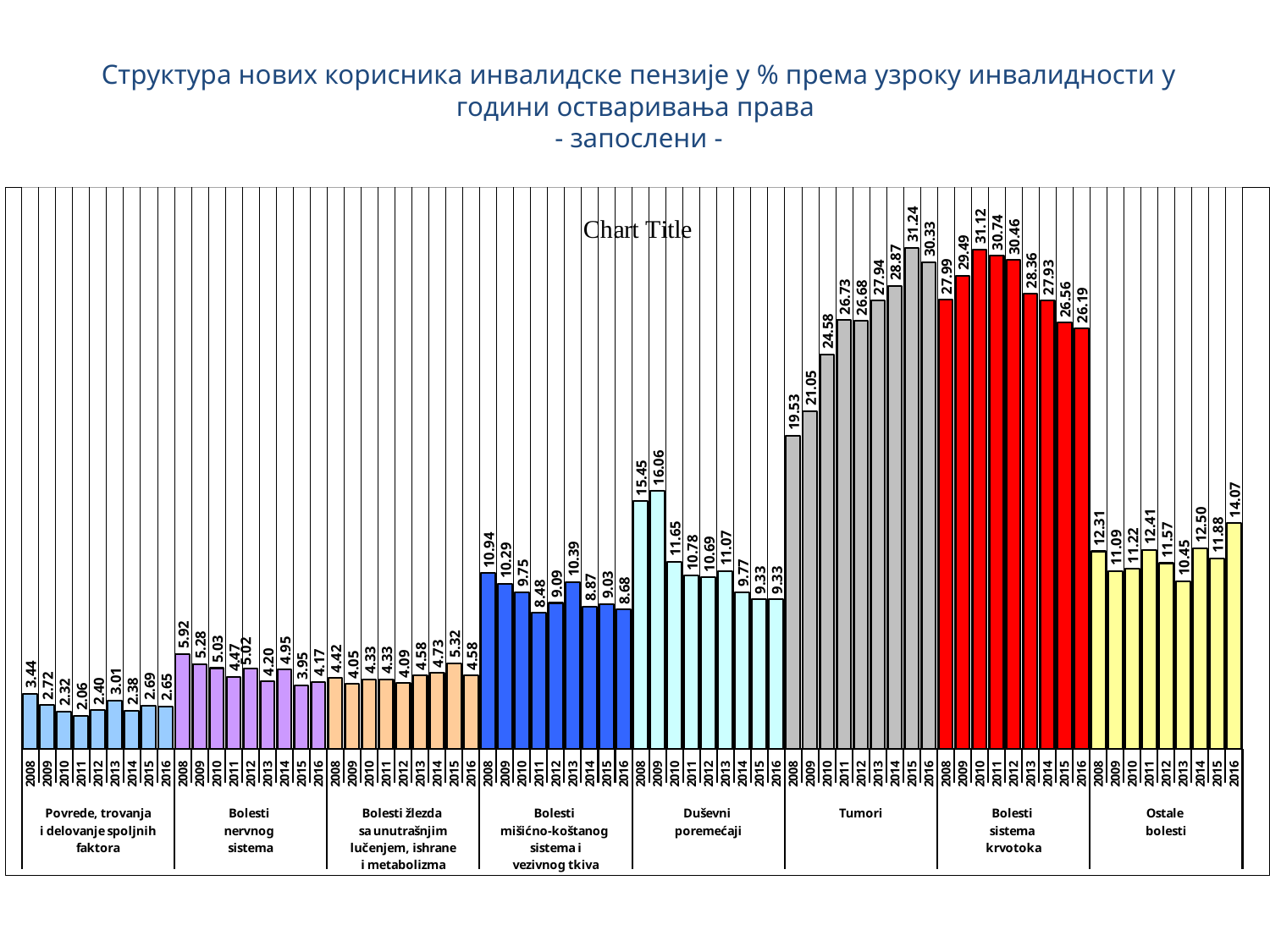
Do the values for Tumori rise or fall from 2008 to 2015? Rise What kind of chart is shown on the slide? Bar chart What value is shown for Bolesti sistema krvotoka in 2010? 31.12 What is the difference between the Tumori values for 2016 and 2008? 10.80 Which year has the highest value in the Tumori group? 2015 What value is shown for Ostale bolesti in 2016? 14.07 What value is shown for Tumori in 2015? 31.24 How many cause-of-disability groups are shown on the chart? 8 What value is shown for Duševni poremećaji in 2009? 16.06 Which year has the lowest value in the Povrede, trovanja i delovanje spoljnih faktora group? 2011 How many bars are plotted in the Tumori group? 9 Which is larger: the 2008 value for Bolesti nervnog sistema or the 2008 value for Bolesti žlezda sa unutrašnjim lučenjem, ishrane i metabolizma? Bolesti nervnog sistema